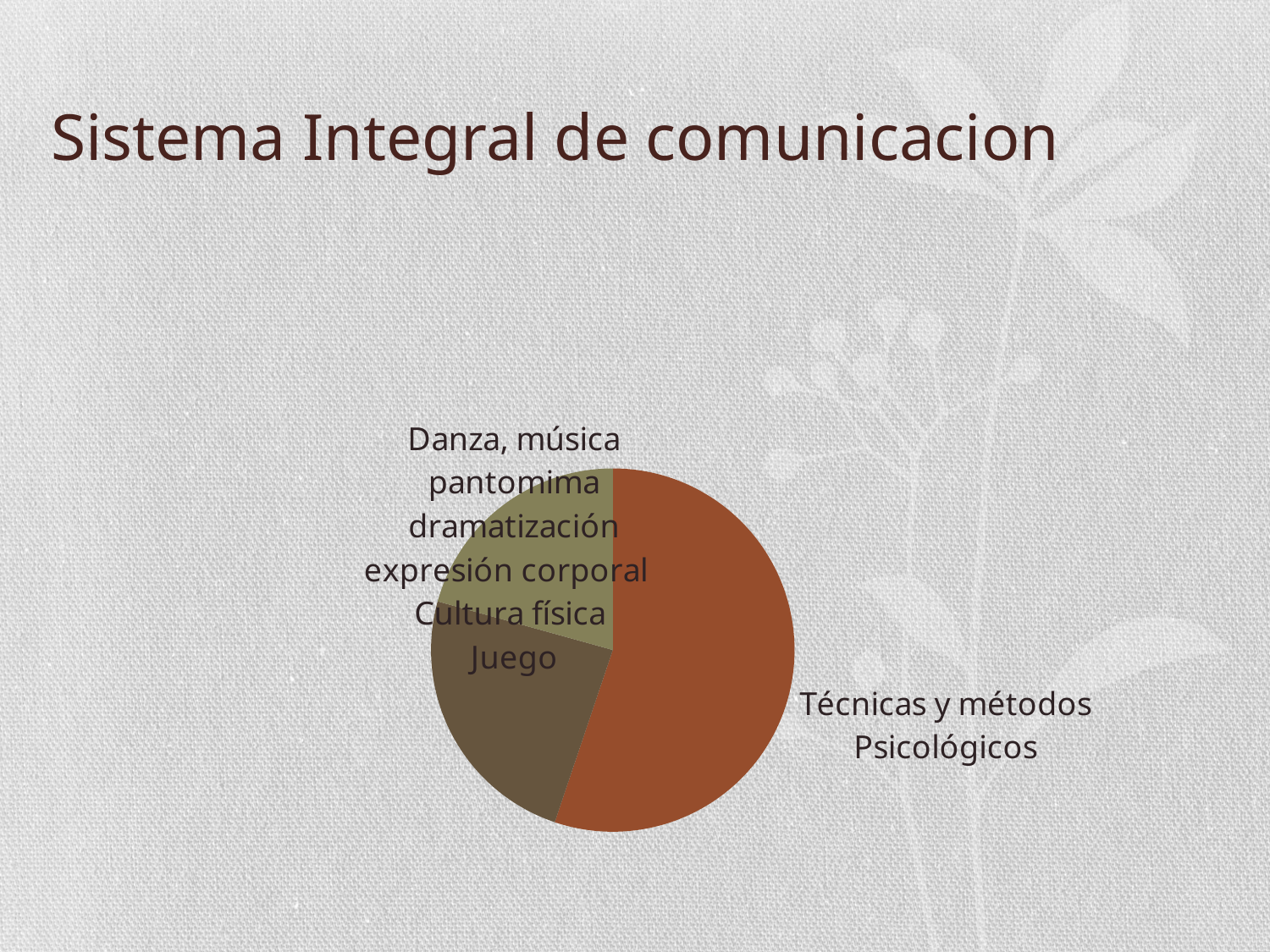
Does the Técnicas y métodos Psicológicos slice take up more or less than half of the pie? more What colour is the Técnicas y métodos Psicológicos slice? orange-brown What kind of chart is shown on the slide? pie chart Which slice of the pie chart is the largest? Técnicas y métodos Psicológicos Which slice is larger: Técnicas y métodos Psicológicos or Cultura física Juego? Técnicas y métodos Psicológicos Which slice is larger: Técnicas y métodos Psicológicos or Danza, música pantomima dramatización expresión corporal? Técnicas y métodos Psicológicos How many slices does the pie chart have? 3 What is the title of the slide containing the pie chart? Sistema Integral de comunicacion